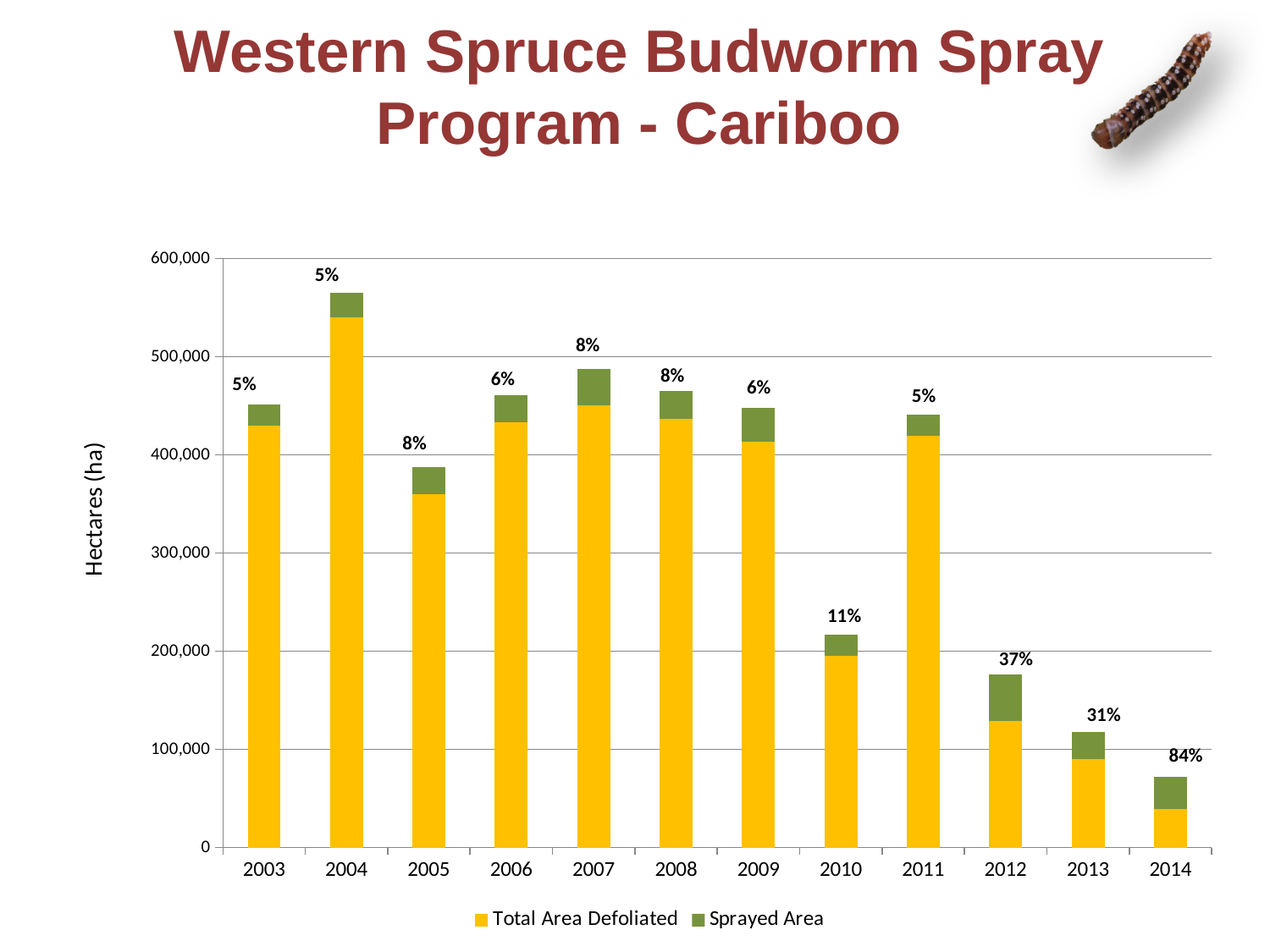
Is the total stacked bar for 2004 greater or less than 500,000 hectares? greater What percentage label is shown above the bar for 2010? 11% How many years are shown on the x axis? 12 Which year has the highest percentage label above its bar? 2014 Is the total stacked bar for 2014 greater or less than 100,000 hectares? less What percentage label is shown above the bar for 2012? 37% Which year has the shortest stacked bar? 2014 What percentage label is shown above the bar for 2014? 84% How many series does the legend list? 2 What type of chart is shown on the slide? stacked bar chart Which year has the tallest stacked bar? 2004 Which year has a taller stacked bar, 2005 or 2007? 2007